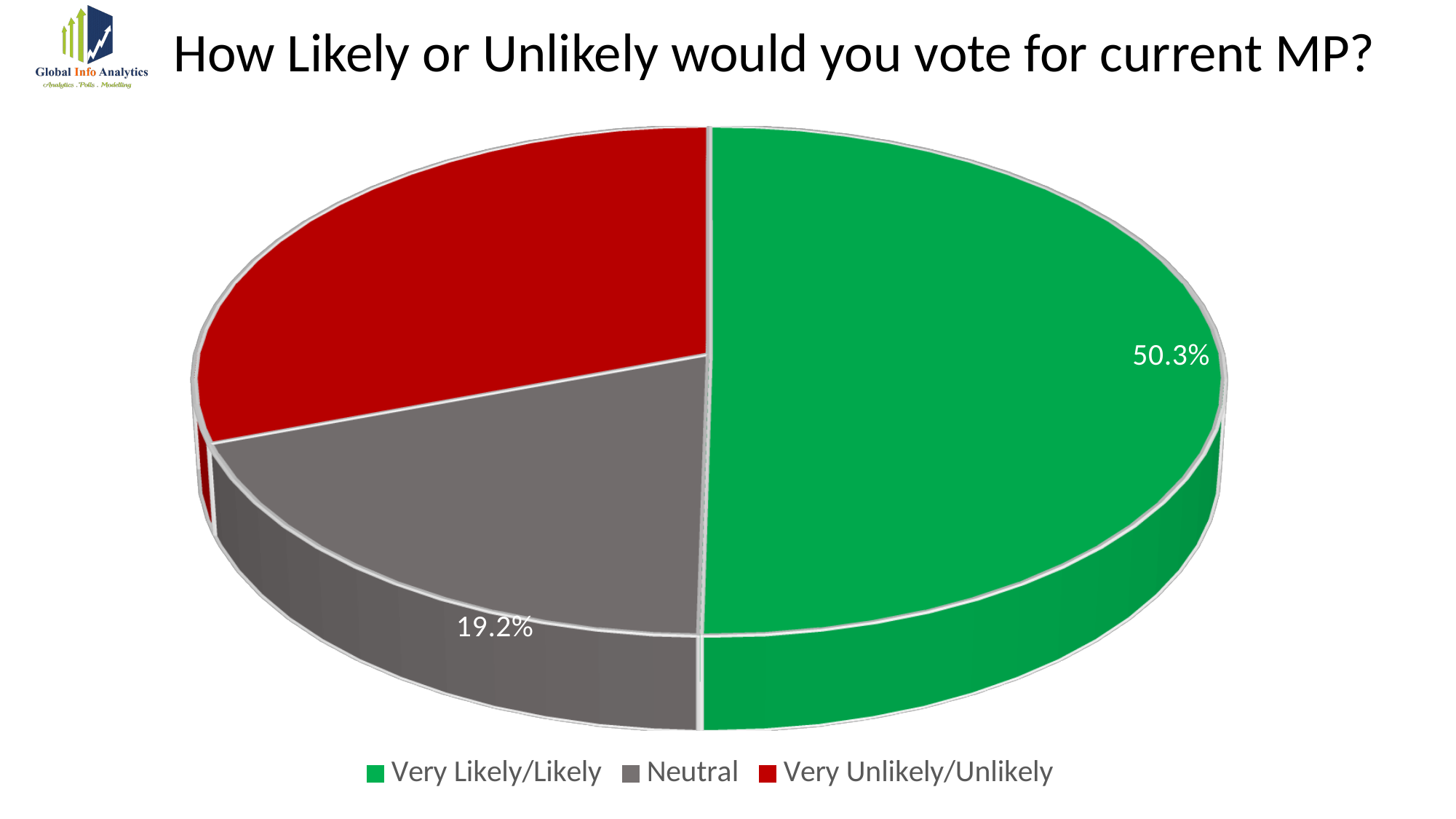
What percentage of respondents answered Very Likely/Likely? 50.3% Which is larger, the Neutral slice or the Very Unlikely/Unlikely slice? Very Unlikely/Unlikely What percentage of respondents answered Neutral? 19.2% Which response category has the smallest share of the pie? Neutral What colour represents the Neutral category in the chart? grey What is the title of the chart? How Likely or Unlikely would you vote for current MP? What is the difference in percentage points between the Very Likely/Likely share and the Neutral share? 31.1 What kind of chart is shown on the slide? pie chart How many categories does the pie chart have? 3 How many entries does the legend list? 3 Which response category has the largest share of the pie? Very Likely/Likely Which is larger, the Very Likely/Likely slice or the Very Unlikely/Unlikely slice? Very Likely/Likely